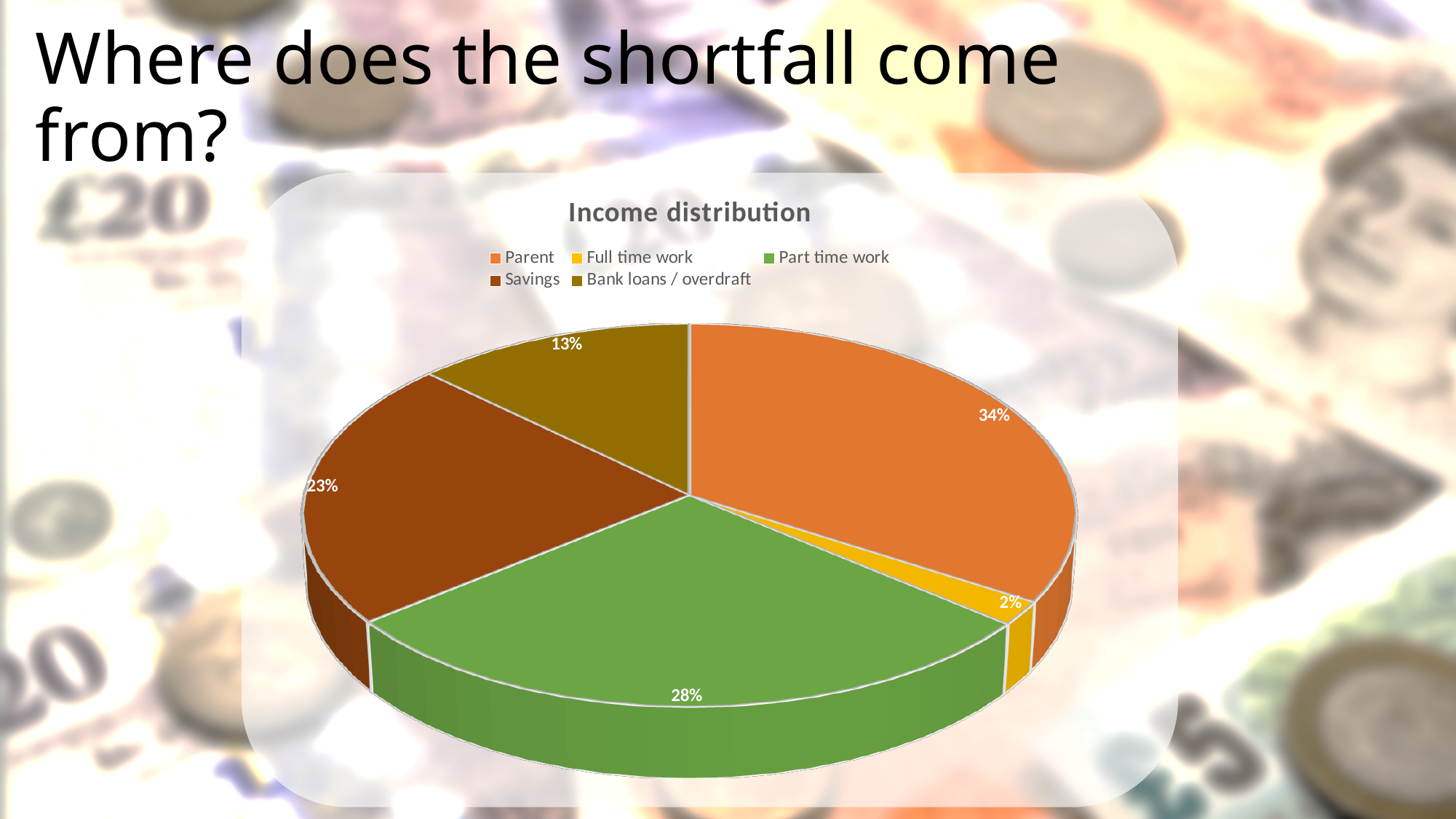
How many categories does the legend list? 5 What share of the pie is Full time work? 2% What share of the pie is Part time work? 28% Which category has the largest share? Parent Which is larger, Part time work or Bank loans / overdraft? Part time work What is the title of the chart? Income distribution What is the difference in percentage points between Parent and Savings? 11 What kind of chart is shown on the slide? Pie chart What share of the pie is Bank loans / overdraft? 13% Which category has the smallest share? Full time work What share of the pie is Savings? 23% What share of the pie is Parent? 34%